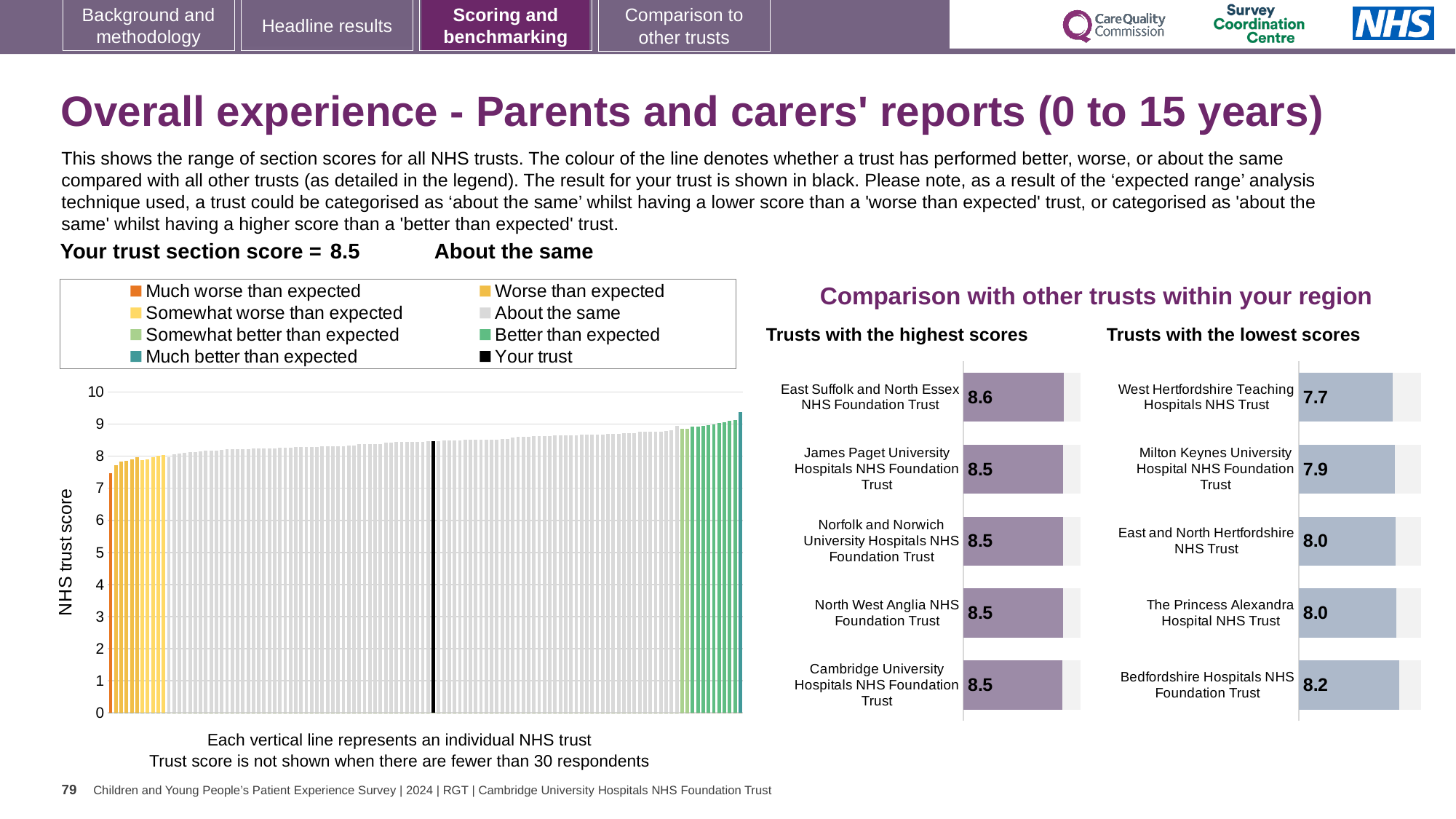
In the 'Trusts with the lowest scores' chart, what is the score for West Hertfordshire Teaching Hospitals NHS Trust? 7.7 How many entries does the legend of the large chart on the left list? 8 In the large chart on the left showing all NHS trusts, is the value for the black 'Your trust' bar greater or less than 8? greater In the 'Trusts with the lowest scores' chart, which has the larger score: Milton Keynes University Hospital NHS Foundation Trust or Bedfordshire Hospitals NHS Foundation Trust? Bedfordshire Hospitals NHS Foundation Trust In the 'Trusts with the highest scores' chart, what is the difference between the scores of East Suffolk and North Essex NHS Foundation Trust and Cambridge University Hospitals NHS Foundation Trust? 0.1 In the 'Trusts with the lowest scores' chart, what is the difference between the scores of Bedfordshire Hospitals NHS Foundation Trust and West Hertfordshire Teaching Hospitals NHS Trust? 0.5 In the 'Trusts with the highest scores' chart, what is the score for East Suffolk and North Essex NHS Foundation Trust? 8.6 In the large chart on the left showing all NHS trusts, do the values rise or fall from left to right along the x axis? rise How many trusts are listed in the 'Trusts with the highest scores' chart? 5 In the 'Trusts with the lowest scores' chart, which trust has the lowest score? West Hertfordshire Teaching Hospitals NHS Trust In the 'Trusts with the highest scores' chart, which trust has the highest score? East Suffolk and North Essex NHS Foundation Trust In the 'Trusts with the lowest scores' chart, what is the score for Bedfordshire Hospitals NHS Foundation Trust? 8.2